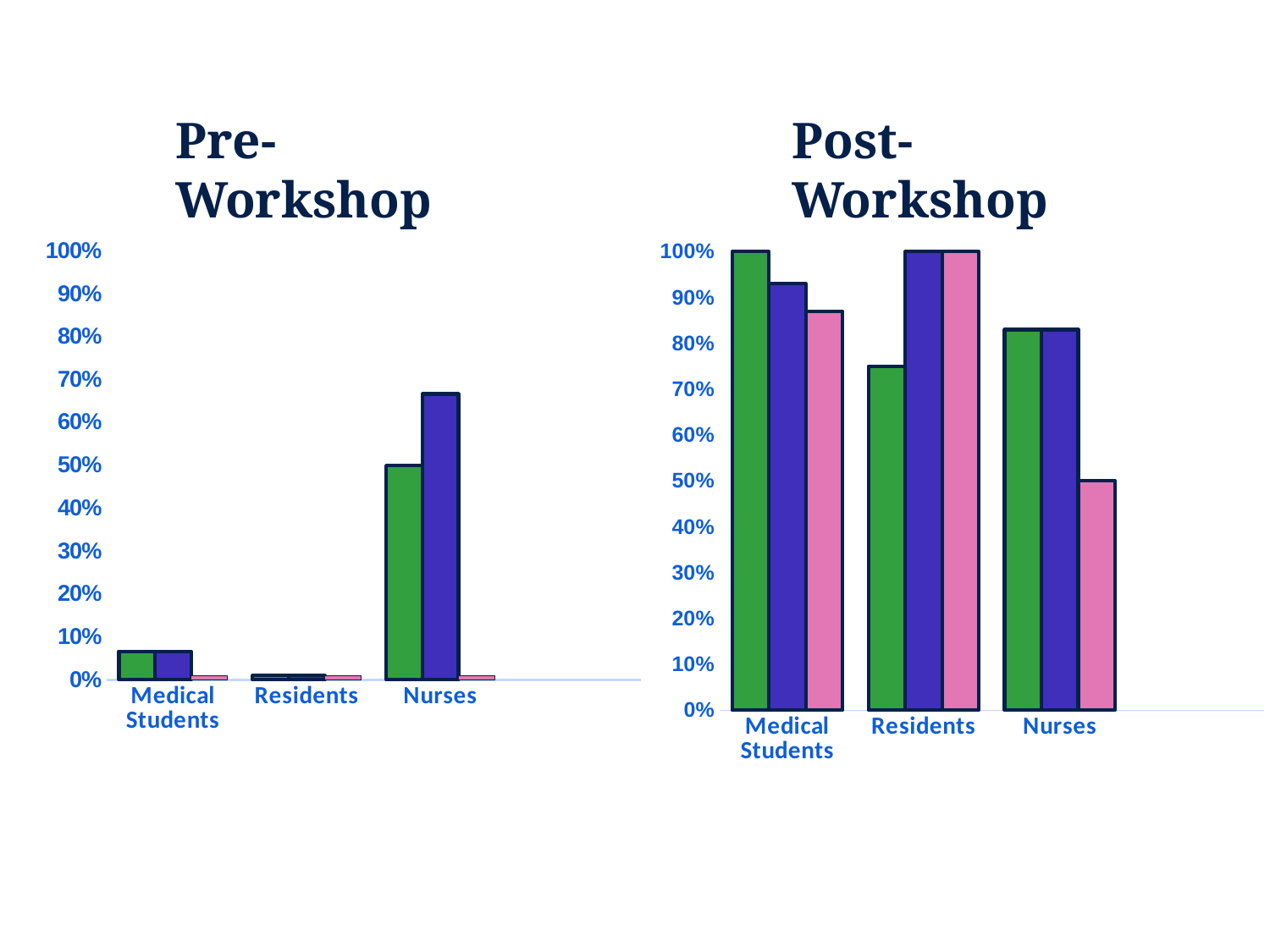
How many categories are shown on the x axis of the Post-Workshop chart? 3 In the Post-Workshop chart, is the value of the green bar for Residents greater or less than 80%? less In the Pre-Workshop chart, which category has the highest green bar? Nurses In the Pre-Workshop chart, is the value of the purple bar for Nurses greater or less than 60%? greater In the Pre-Workshop chart, which category has the lowest purple bar? Residents What kind of chart is the Pre-Workshop chart? bar chart In the Post-Workshop chart, which category has the lowest pink bar? Nurses In the Post-Workshop chart, which is larger for Medical Students: the purple bar or the pink bar? the purple bar In the Post-Workshop chart, what is the value of the pink bar for Nurses? 50% In the Post-Workshop chart, what is the value of the green bar for Medical Students? 100% What is the title of the chart on the right side of the slide? Post-Workshop In the Pre-Workshop chart, what is the value of the green bar for Nurses? 50%